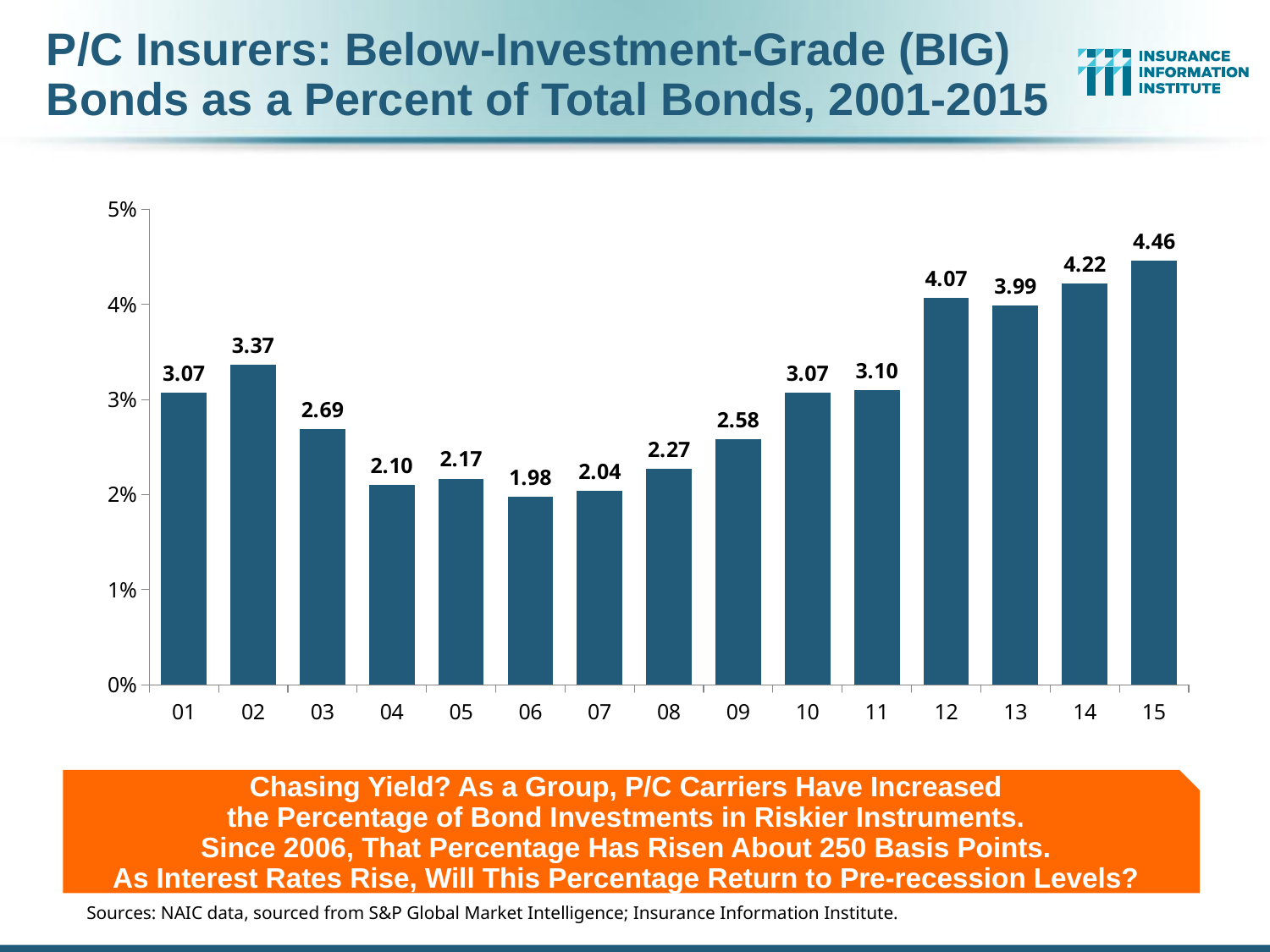
Which is larger, the value for 2012 or the value for 2013? 2012 (4.07) Which year has the highest value? 15 Which year has the lowest value? 06 Do the values rise or fall from 2011 to 2012? rise How many years are shown on the x axis? 15 What is the title of the chart? P/C Insurers: Below-Investment-Grade (BIG) Bonds as a Percent of Total Bonds, 2001-2015 What is the value for 2009 (labelled 09)? 2.58 What kind of chart is this? bar chart What is the value for 2015 (labelled 15)? 4.46 What is the difference between the values for 2015 and 2006? 2.48 What is the value for 2006 (labelled 06)? 1.98 Is the value for 2003 greater or less than 3%? less